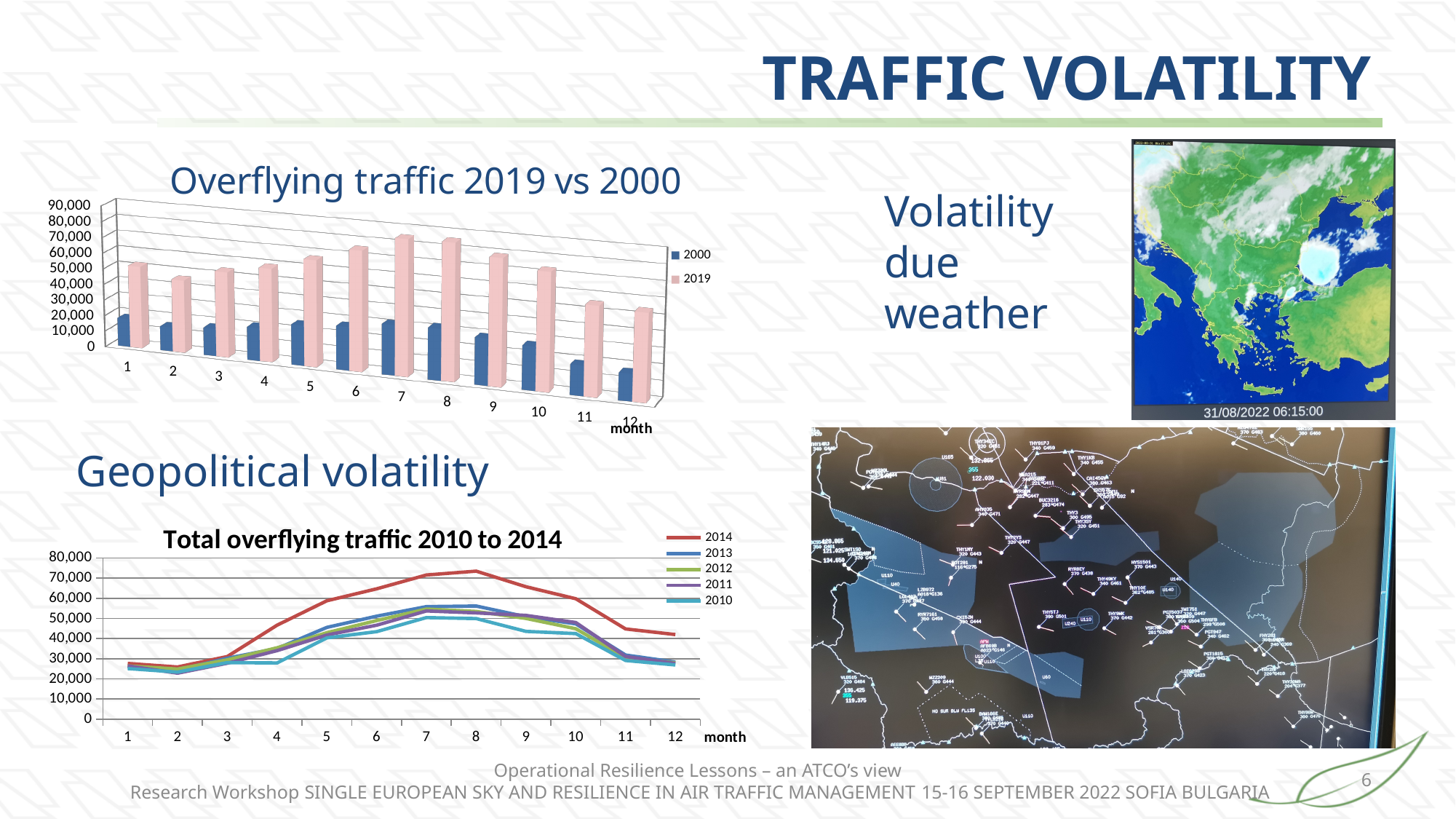
In the 'Overflying traffic 2019 vs 2000' chart, is the 2000 value for month 12 greater or less than 10,000? greater In the 'Overflying traffic 2019 vs 2000' chart, is the 2019 value for month 7 greater or less than 60,000? greater In the 'Total overflying traffic 2010 to 2014' chart, which series has the larger value in month 8, 2014 or 2010? 2014 In the 'Total overflying traffic 2010 to 2014' chart, which month has the highest value for 2014? 8 What type of chart is the 'Total overflying traffic 2010 to 2014' chart? line chart How many series does the legend of the 'Total overflying traffic 2010 to 2014' chart list? 5 In the 'Overflying traffic 2019 vs 2000' chart, which series has the larger value in month 6, 2000 or 2019? 2019 How many series does the legend of the 'Overflying traffic 2019 vs 2000' chart list? 2 In the 'Total overflying traffic 2010 to 2014' chart, is the 2014 value for month 8 greater or less than 60,000? greater How many months are shown on the x axis of the 'Overflying traffic 2019 vs 2000' chart? 12 What type of chart is the 'Overflying traffic 2019 vs 2000' chart? bar chart